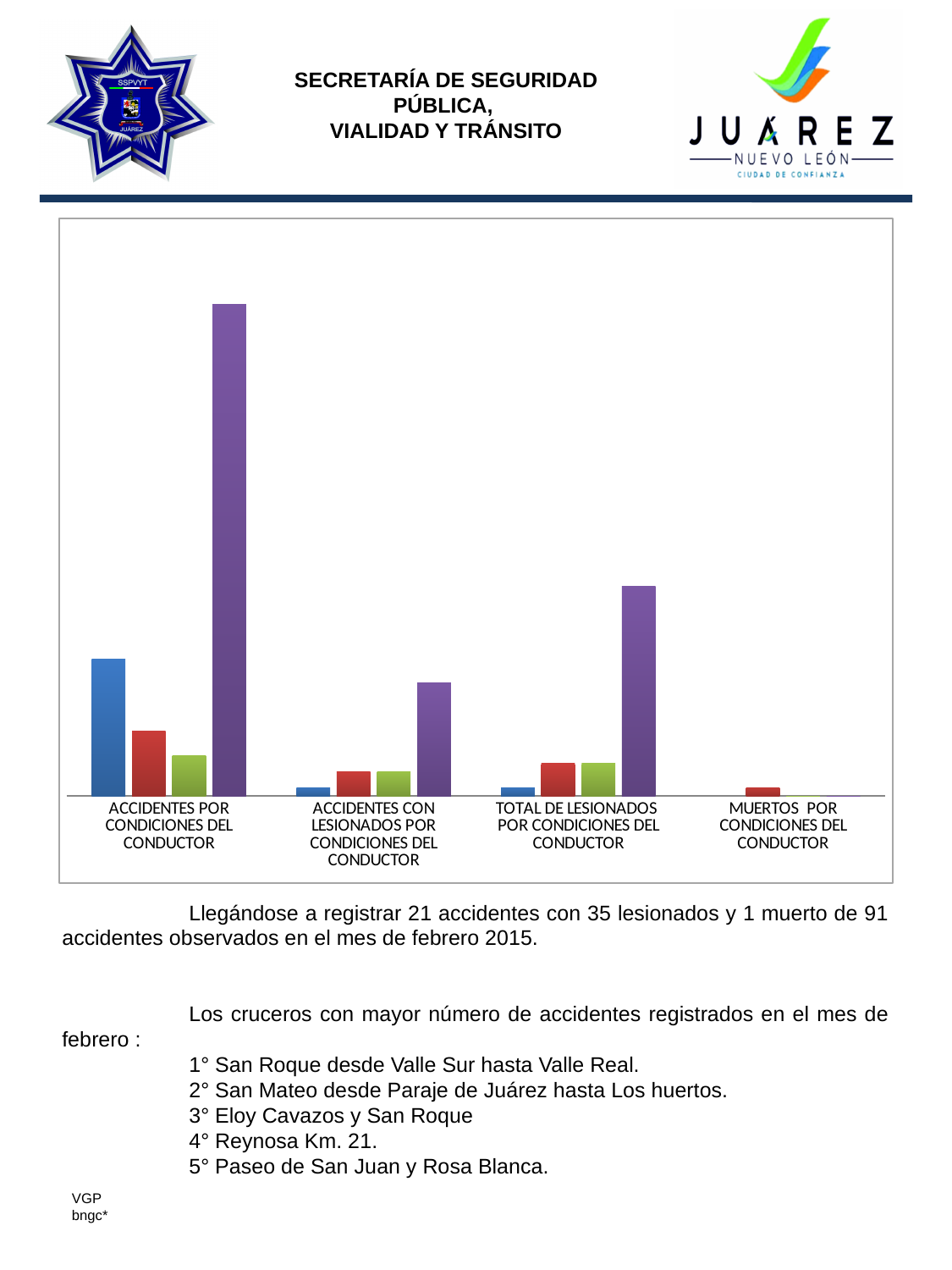
Which category contains the tallest bar in the chart? ACCIDENTES POR CONDICIONES DEL CONDUCTOR In the category ACCIDENTES CON LESIONADOS POR CONDICIONES DEL CONDUCTOR, which is taller, the blue bar or the red bar? the red bar In the category TOTAL DE LESIONADOS POR CONDICIONES DEL CONDUCTOR, which is taller, the green bar or the purple bar? the purple bar What colour is the tallest bar in the chart? purple Which category has the shortest bars overall in the chart? MUERTOS POR CONDICIONES DEL CONDUCTOR How many bars are plotted for each category in the chart? 4 How many categories are shown along the x axis of the chart? 4 Does the chart display a legend? No What kind of chart is shown on the slide? bar chart In the category MUERTOS POR CONDICIONES DEL CONDUCTOR, which coloured bar is the tallest? the red bar